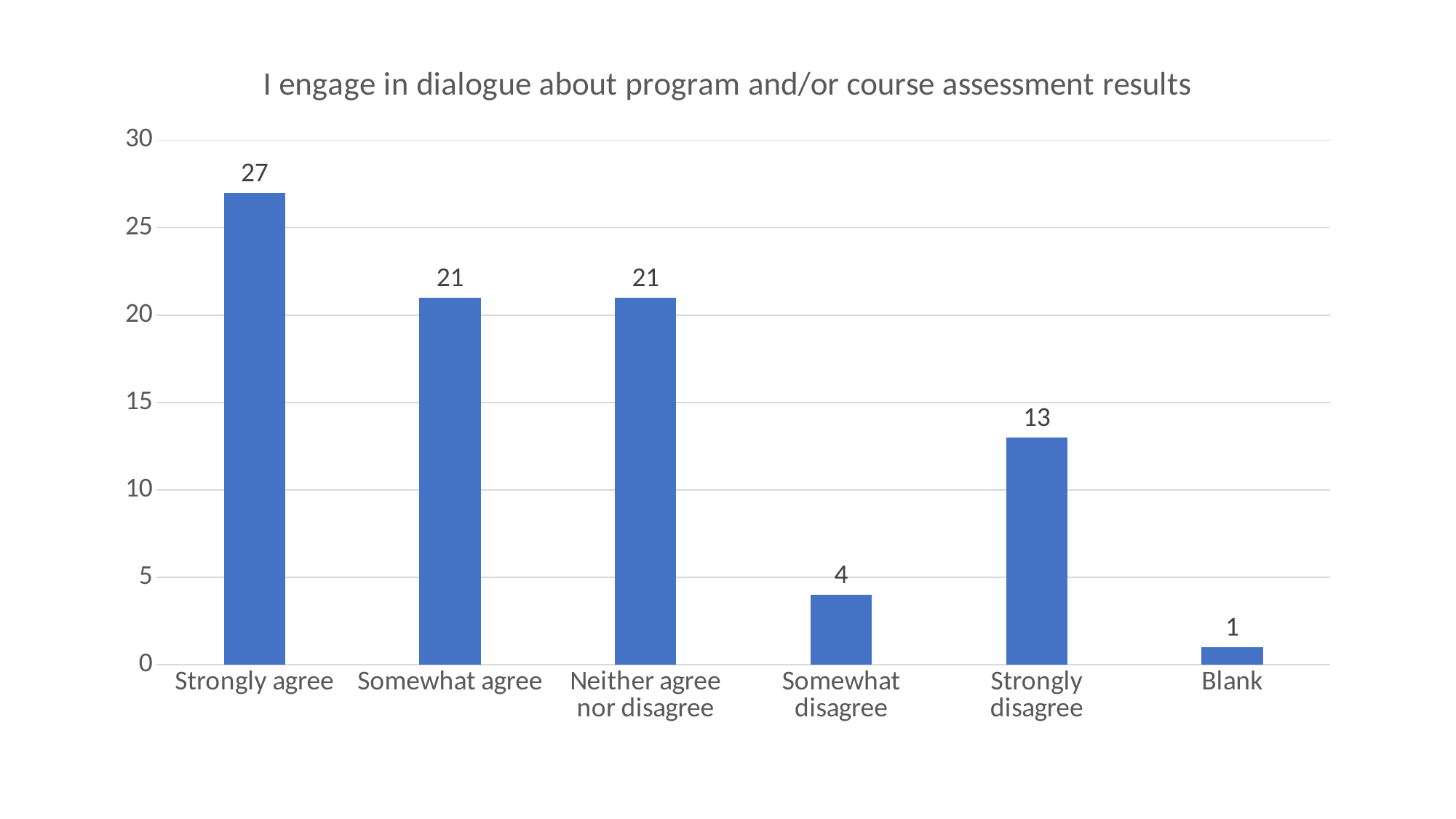
What is the difference between the values for Strongly agree and Strongly disagree? 14 What is the value for Blank? 1 What kind of chart is this? Bar chart What is the difference between the values for Somewhat agree and Somewhat disagree? 17 What is the value for Somewhat disagree? 4 What is the value for Strongly agree? 27 What is the title of the chart? I engage in dialogue about program and/or course assessment results What is the value for Strongly disagree? 13 Which is larger, the value for Strongly disagree or the value for Somewhat disagree? Strongly disagree Which category has the highest value? Strongly agree How many categories are shown on the x axis? 6 Which category has the lowest value? Blank